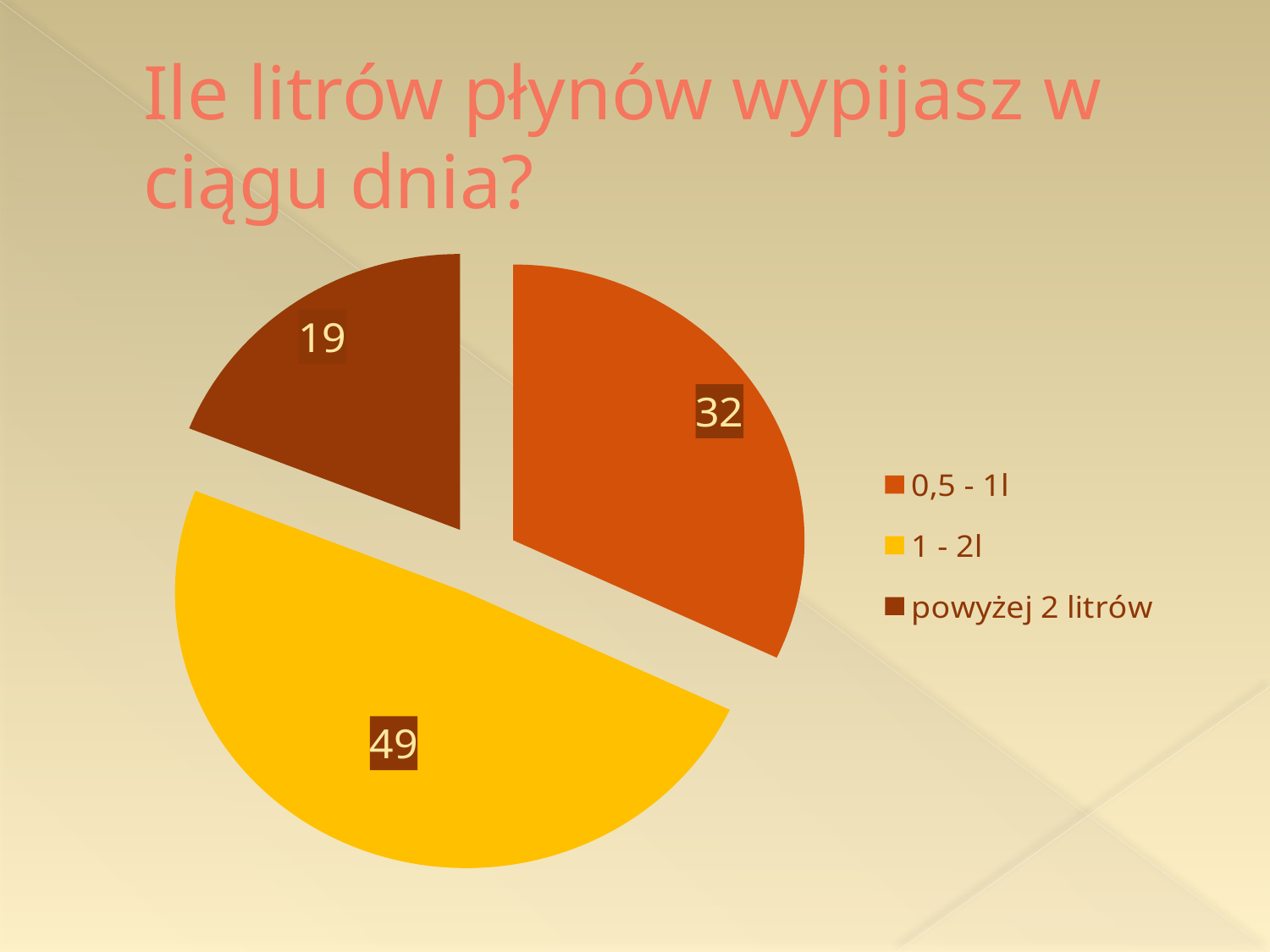
What is the difference between the values for "0,5 - 1l" and "powyżej 2 litrów"? 13 Which category has the largest slice? 1 - 2l Which is larger, the value for "0,5 - 1l" or the value for "powyżej 2 litrów"? 0,5 - 1l How many slices does the pie chart have? 3 Which category has the smallest slice? powyżej 2 litrów What is the value for the "0,5 - 1l" slice? 32 What is the value for the "powyżej 2 litrów" slice? 19 What is the value for the "1 - 2l" slice? 49 What is the title of the slide containing the chart? Ile litrów płynów wypijasz w ciągu dnia? What kind of chart is shown on the slide? pie chart What share of the pie does the "1 - 2l" slice represent? 49% What is the difference between the values for "1 - 2l" and "0,5 - 1l"? 17